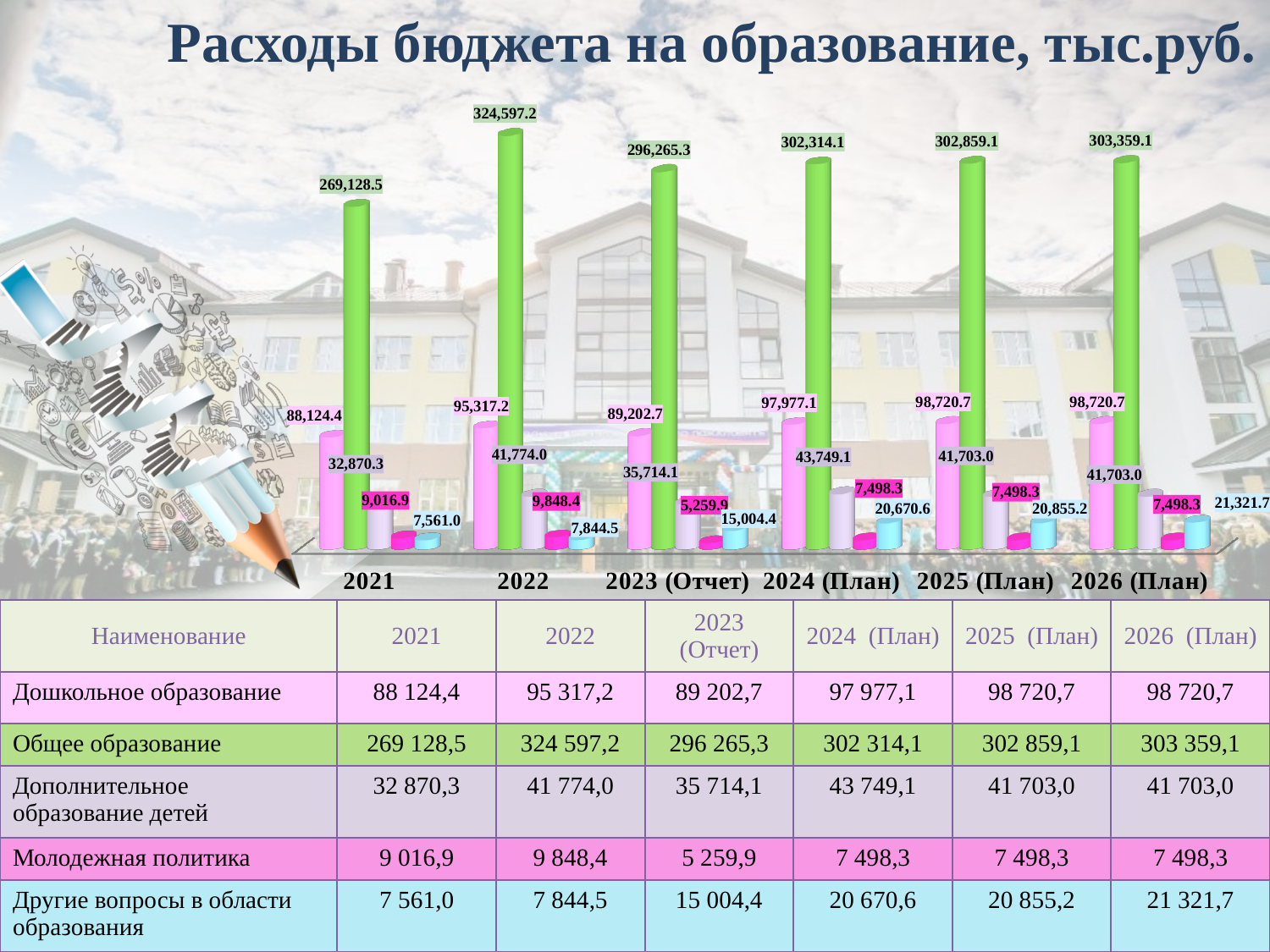
What is the title of the chart on the slide? Расходы бюджета на образование, тыс.руб. Which is larger: the pink bar for 2022 or the pink bar for 2023 (Отчет)? 2022 How many year categories are shown along the x axis of the chart? 6 What is the difference between the green bar values for 2022 and 2021? 55,468.7 What is the value labelled on the light blue bar (Другие вопросы в области образования) for 2026 (План)? 21,321.7 In which year is the magenta series (Молодежная политика) at its lowest value? 2023 (Отчет) What type of chart is shown on the slide? bar chart What is the value of the tallest green bar (Общее образование) for 2022? 324,597.2 What is the value labelled on the pink bar (Дошкольное образование) for 2021? 88,124.4 Does the light blue series (Другие вопросы в области образования) rise or fall from 2021 to 2026 (План)? rise In which year does the green series (Общее образование) reach its highest value? 2022 What is the difference between the light purple bar values for 2024 (План) and 2023 (Отчет)? 8,035.0